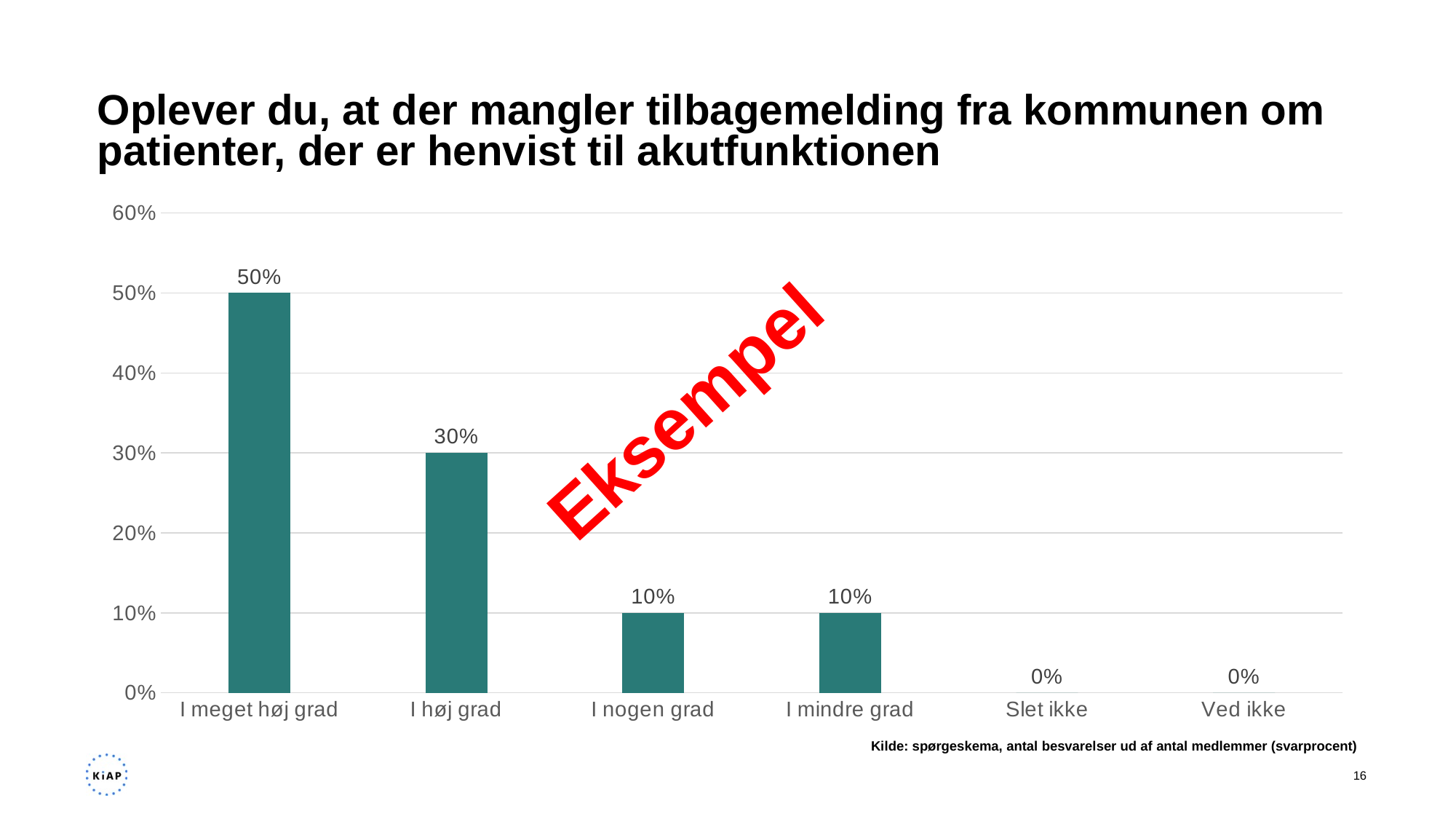
What is the difference between the values for "I meget høj grad" and "I høj grad"? 20% What is the difference between the values for "I høj grad" and "I mindre grad"? 20% What is the value for "Slet ikke"? 0% Which category has the highest value? I meget høj grad What is the value for "I høj grad"? 30% Which is larger, the value for "I høj grad" or the value for "I nogen grad"? I høj grad How many categories are shown on the x axis? 6 What kind of chart is shown on the slide? Bar chart What is the value for "I meget høj grad"? 50% Do the values rise or fall from left to right along the x axis? Fall What is the value for "I nogen grad"? 10% What red word is written diagonally across the chart? Eksempel